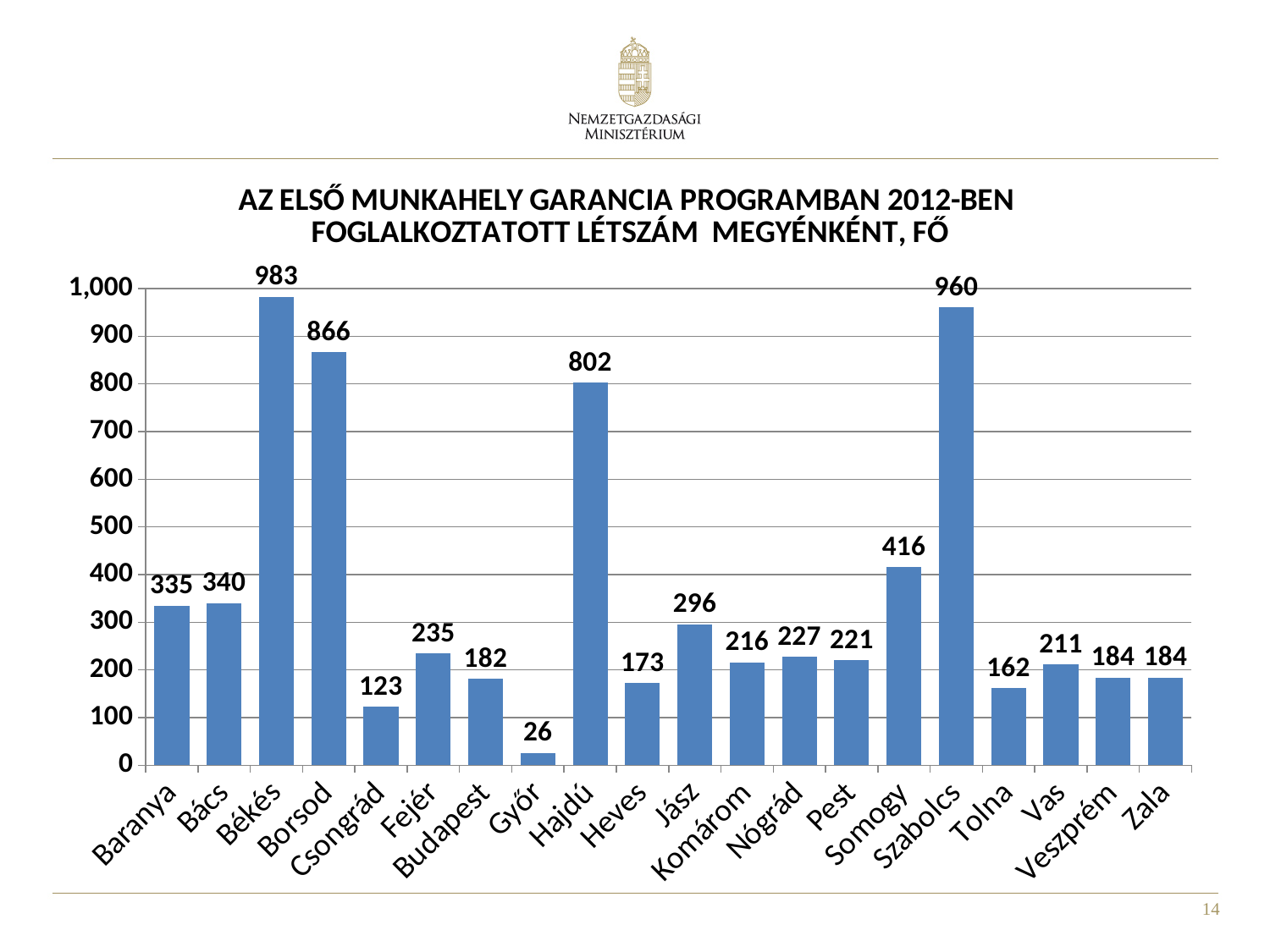
What is the value for Somogy? 416 What is the value for Békés? 983 What kind of chart is shown on the slide? bar chart Which county has the highest value? Békés What is the title of the chart? AZ ELSŐ MUNKAHELY GARANCIA PROGRAMBAN 2012-BEN FOGLALKOZTATOTT LÉTSZÁM MEGYÉNKÉNT, FŐ Which county has the lowest value? Győr How many counties are shown on the x axis? 20 What is the difference between the values for Békés and Szabolcs? 23 Which is larger, the value for Jász or the value for Komárom? Jász What is the difference between the values for Hajdú and Borsod? 64 Is the value for Somogy greater or less than 400? greater What is the value for Győr? 26